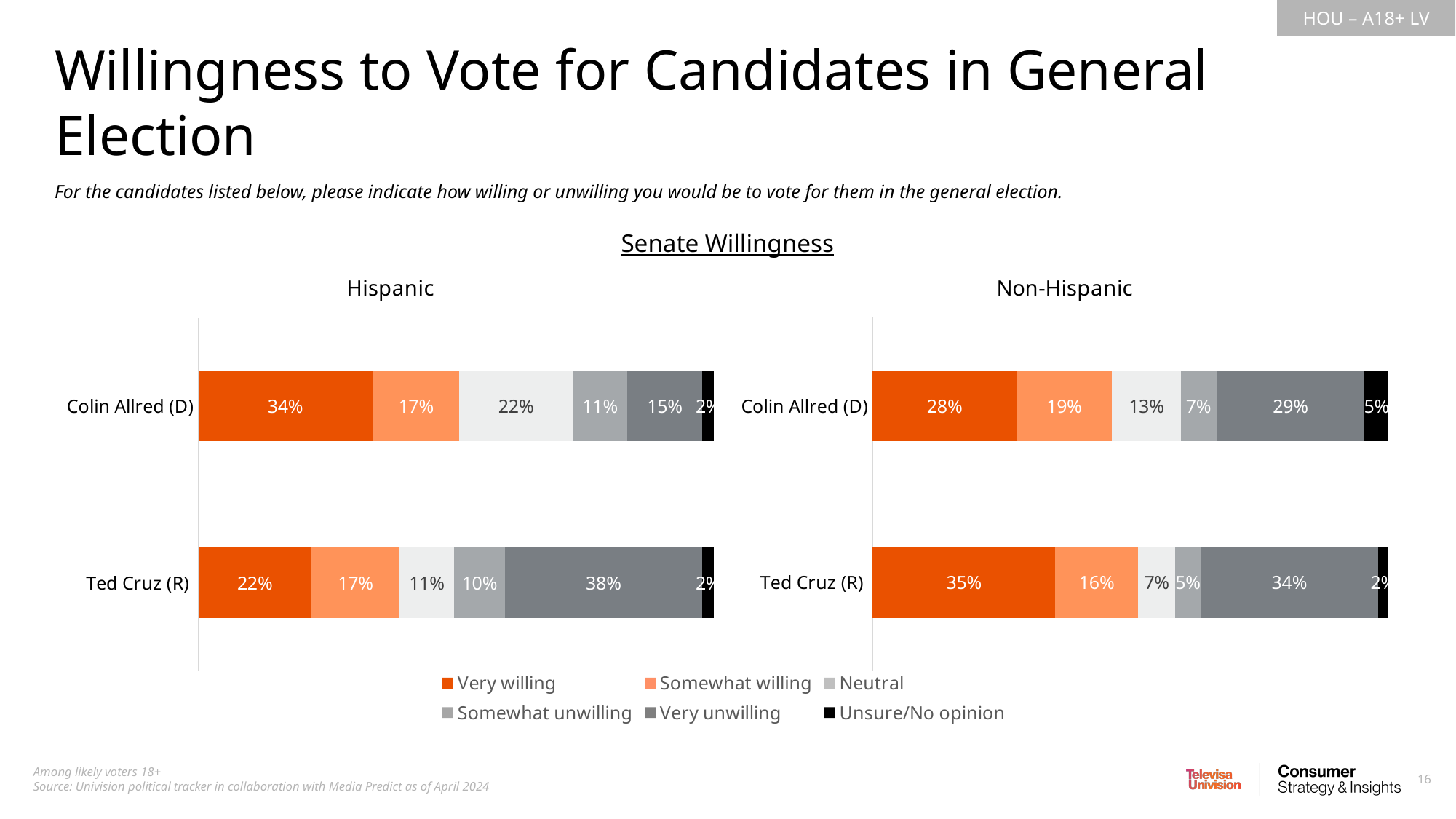
In the Hispanic chart, which candidate has the higher very unwilling percentage? Ted Cruz (R) What kind of chart is used for the Hispanic and Non-Hispanic data? Stacked bar chart In the Hispanic chart, what is the combined very willing and somewhat willing percentage for Ted Cruz (R)? 39% In the Non-Hispanic chart, what percentage of respondents are very unwilling to vote for Ted Cruz (R)? 34% In the Hispanic chart, what percentage of respondents are neutral on Ted Cruz (R)? 11% In the Non-Hispanic chart, what percentage of respondents are unsure/no opinion on Colin Allred (D)? 5% How many candidates are shown in the Non-Hispanic chart? 2 In the Non-Hispanic chart, which candidate has the lower very willing percentage? Colin Allred (D) In the Hispanic chart, what is the difference between the very willing percentages for Colin Allred (D) and Ted Cruz (R)? 12% In the Hispanic chart, what percentage of respondents are very willing to vote for Colin Allred (D)? 34% In the Non-Hispanic chart, is the somewhat willing percentage larger for Colin Allred (D) or Ted Cruz (R)? Colin Allred (D) How many series does the legend list? 6